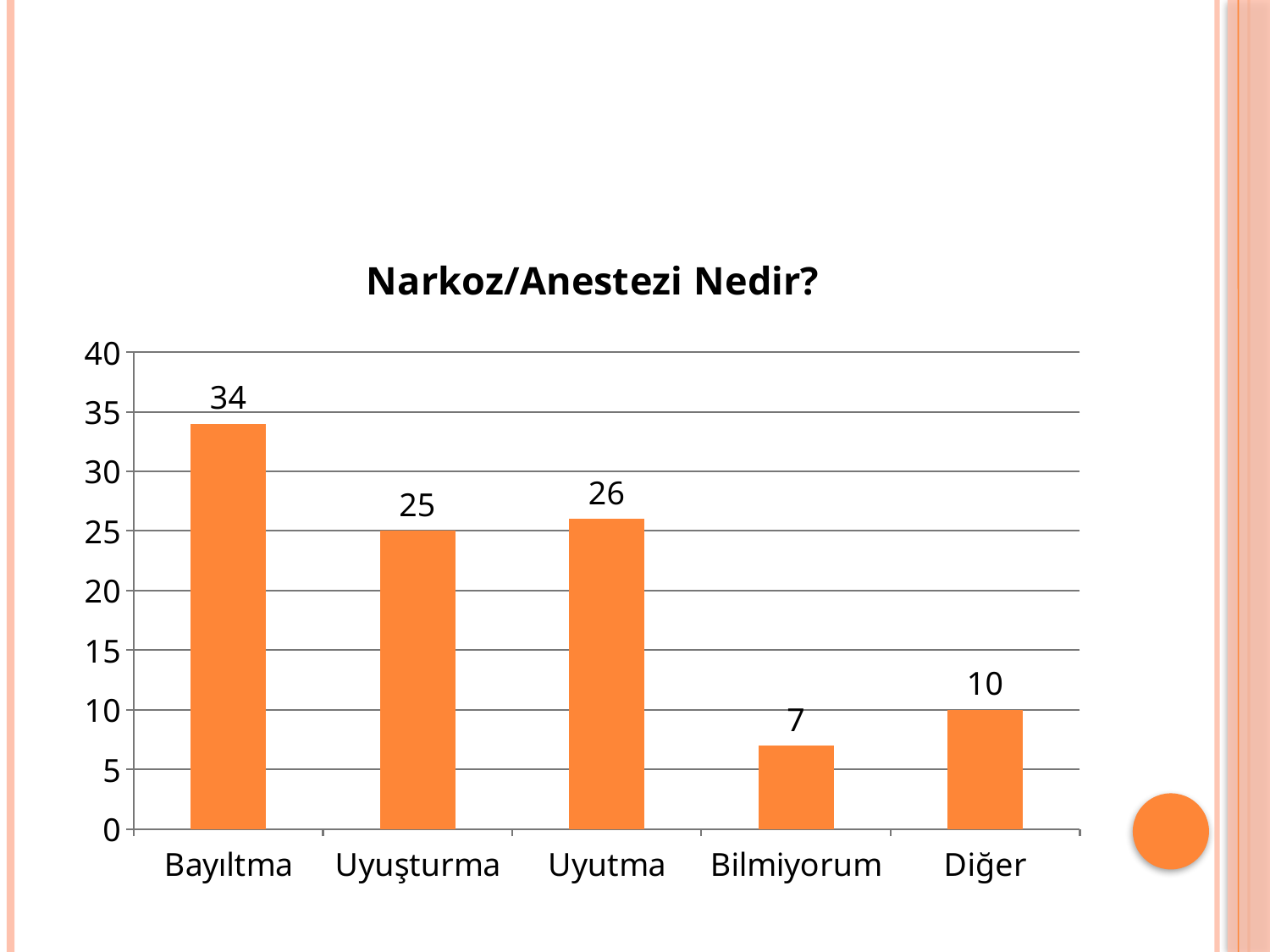
Is the value for Diğer greater or less than 15? less What is the value for Bayıltma? 34 Which category has the lowest value? Bilmiyorum What kind of chart is shown on the slide? bar chart Which is larger, the value for Uyutma or the value for Uyuşturma? Uyutma What is the value for Diğer? 10 What is the title of the chart? Narkoz/Anestezi Nedir? How many categories are shown on the x axis? 5 Which category has the highest value? Bayıltma What is the difference between the values for Bayıltma and Uyutma? 8 What is the value for Uyuşturma? 25 What is the value for Bilmiyorum? 7